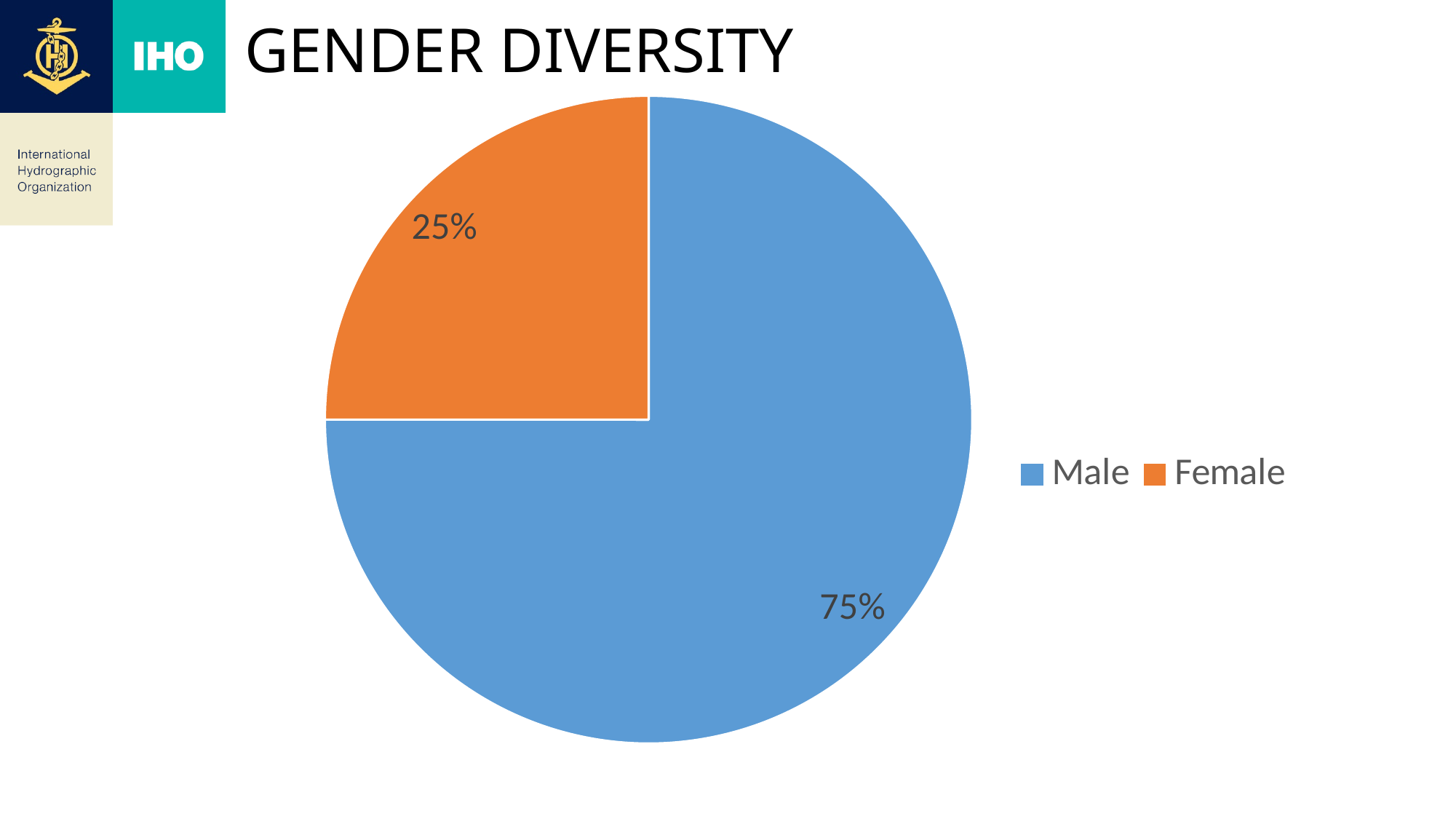
Which is larger, the Male share or the Female share? Male How many categories are shown in the pie chart? 2 What is the title of the slide? GENDER DIVERSITY What share of the pie does the Female slice represent? 25% What colour is the Female slice in the pie chart? Orange Which category has the largest share of the pie chart? Male How many entries does the legend list? 2 What percentage of the pie chart is Female? 25% What is the difference in percentage points between the Male and Female shares? 50 What kind of chart is shown on the slide? Pie chart What percentage of the pie chart is Male? 75% Which category has the smallest share of the pie chart? Female